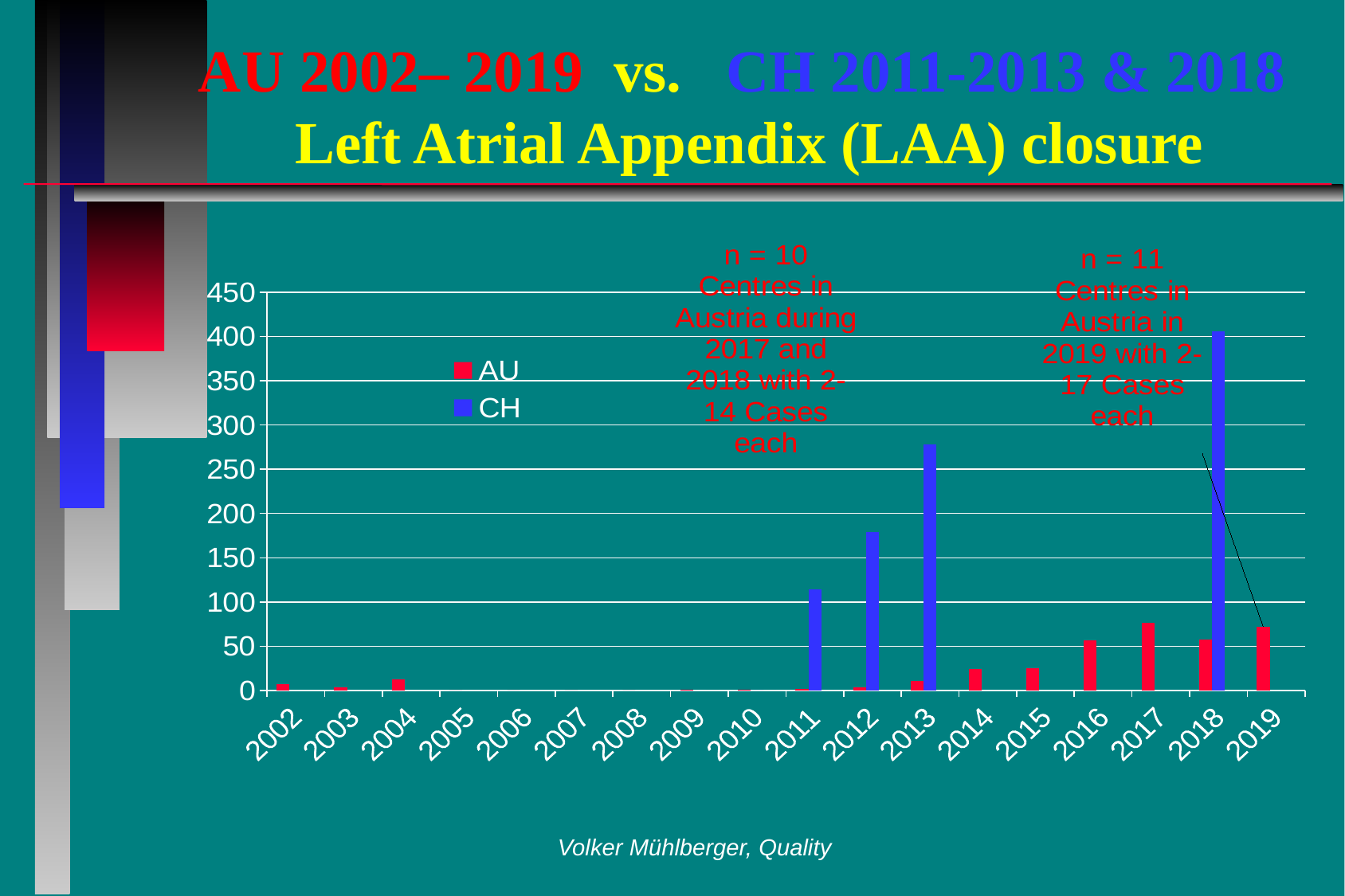
Is the CH value for 2011 greater or less than 100? greater Is the CH value for 2013 greater or less than 250? greater What kind of chart is shown on the slide? bar chart Is the AU value for 2017 greater or less than 100? less Which is larger in 2018, the AU value or the CH value? CH Which colour represents the AU series in the legend? red Do the CH values rise or fall from 2011 to 2013? rise In which year is the CH value highest? 2018 How many years are shown on the x axis? 18 How many series does the legend list? 2